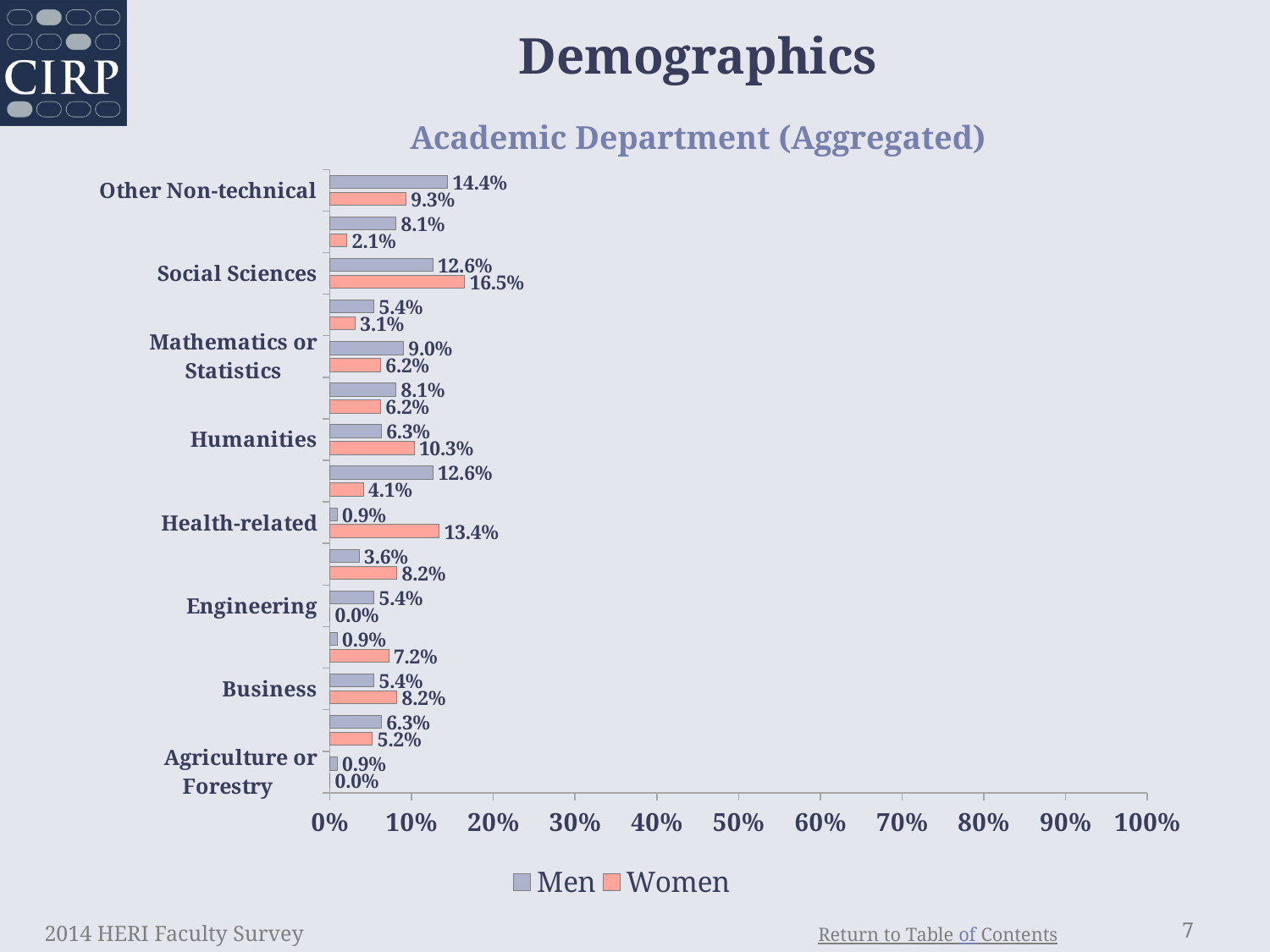
What is the value for Men in the Other Non-technical category? 14.4% What is the difference between the Women and Men values in the Health-related category? 12.5% What is the difference between the Men and Women values in the Mathematics or Statistics category? 2.8% In the Humanities category, which is larger, the value for Men or for Women? Women What is the value for Women in the Health-related category? 13.4% Which category has the highest value for Women? Social Sciences How many series does the legend list? 2 What is the value for Women in the Engineering category? 0.0% Which category has the highest value for Men? Other Non-technical What is the value for Men in the Social Sciences category? 12.6% Is the value for Women in Social Sciences greater or less than 10%? greater What kind of chart is shown on the slide? Bar chart